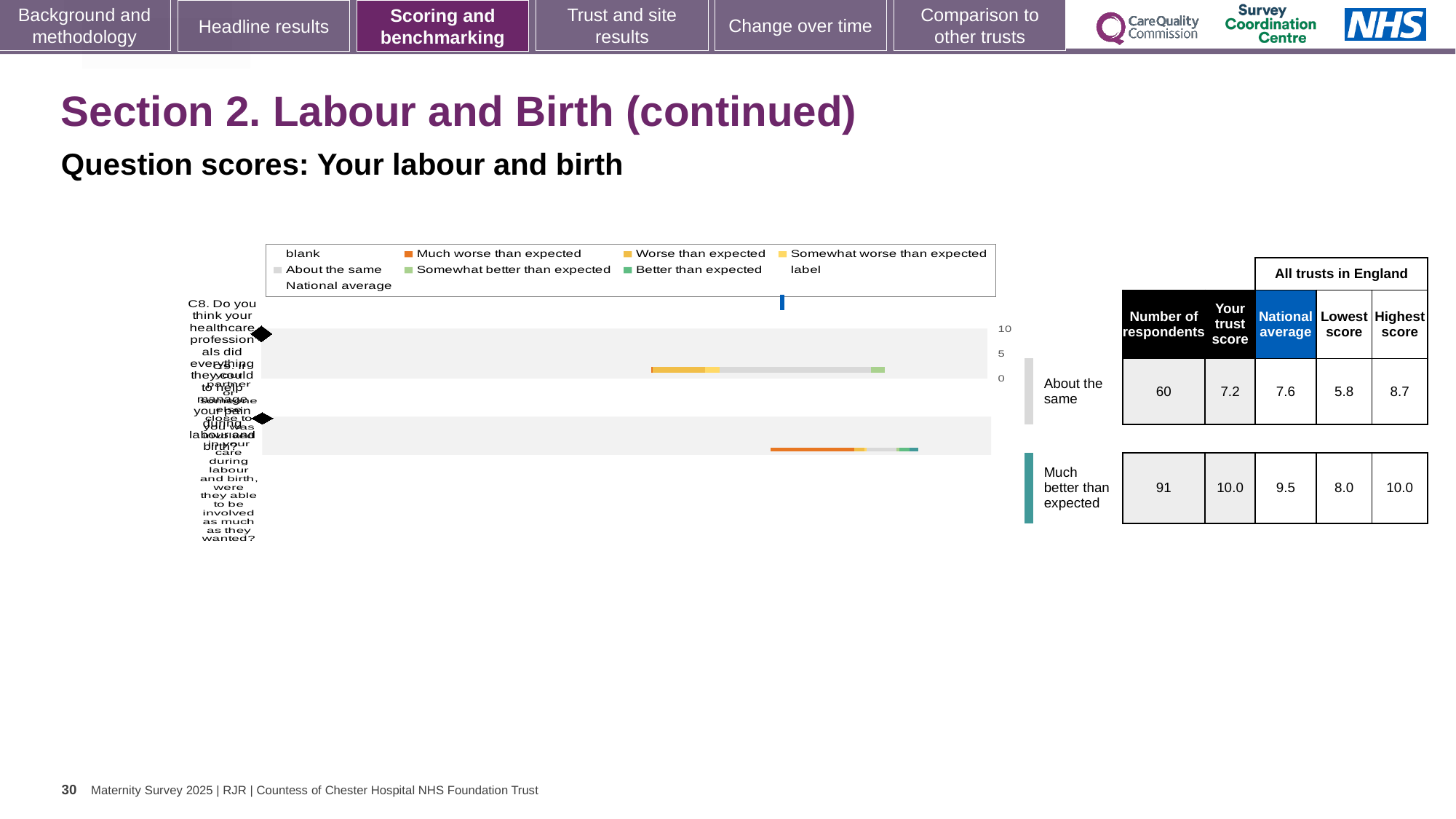
In the table beside the chart, what is the highest score for the row labelled 'About the same'? 8.7 What kind of chart is shown on the slide? bar chart In the table beside the chart, what is the difference between the trust score and the national average for the row labelled 'Much better than expected'? 0.5 Which legend entry is shown in orange? Much worse than expected How many bars are plotted in the chart? 2 In the table beside the chart, what is the lowest score for the row labelled 'Much better than expected'? 8.0 In the table beside the chart, what is the difference between the highest score and the lowest score for the row labelled 'About the same'? 2.9 In the table beside the chart, what is the trust score for the row labelled 'Much better than expected'? 10.0 In the table beside the chart, for the row labelled 'About the same', which is larger: the trust score or the national average? National average In the table beside the chart, what is the number of respondents for the row labelled 'About the same'? 60 In the table beside the chart, what is the national average for the row labelled 'About the same'? 7.6 Which legend entry is shown in grey? About the same